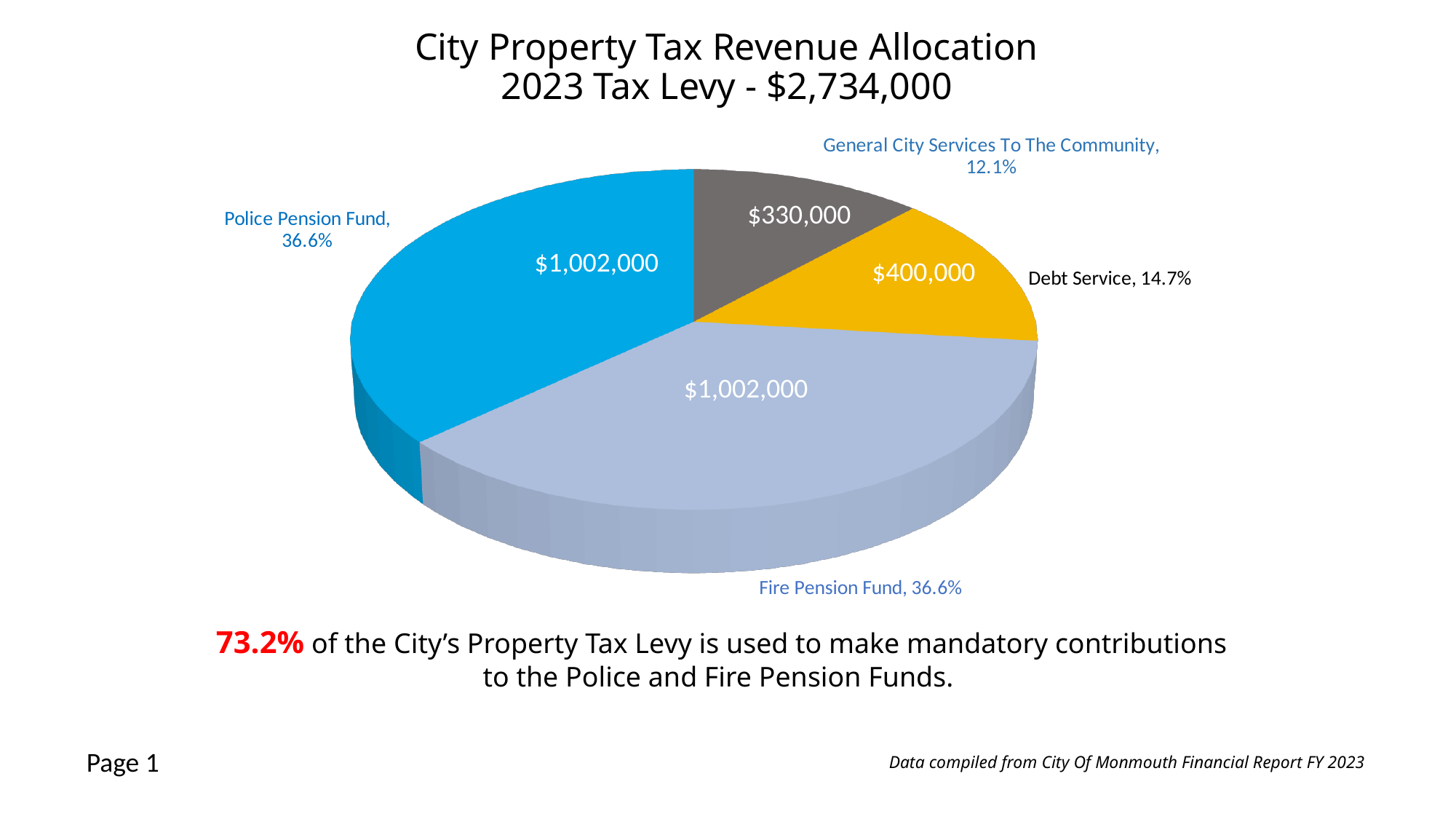
Which category has the smallest slice of the pie? General City Services To The Community What share of the pie does the Fire Pension Fund represent? 36.6% What is the total 2023 tax levy shown in the chart title? $2,734,000 What kind of chart is shown on the slide? Pie chart What is the value of the General City Services To The Community slice? $330,000 What is the value of the Police Pension Fund slice? $1,002,000 What is the difference between the Debt Service value and the General City Services To The Community value? $70,000 What share of the pie does Debt Service represent? 14.7% Which is larger, Debt Service or General City Services To The Community? Debt Service How many slices does the pie chart have? 4 What is the value of the Debt Service slice? $400,000 What is the value of the Fire Pension Fund slice? $1,002,000